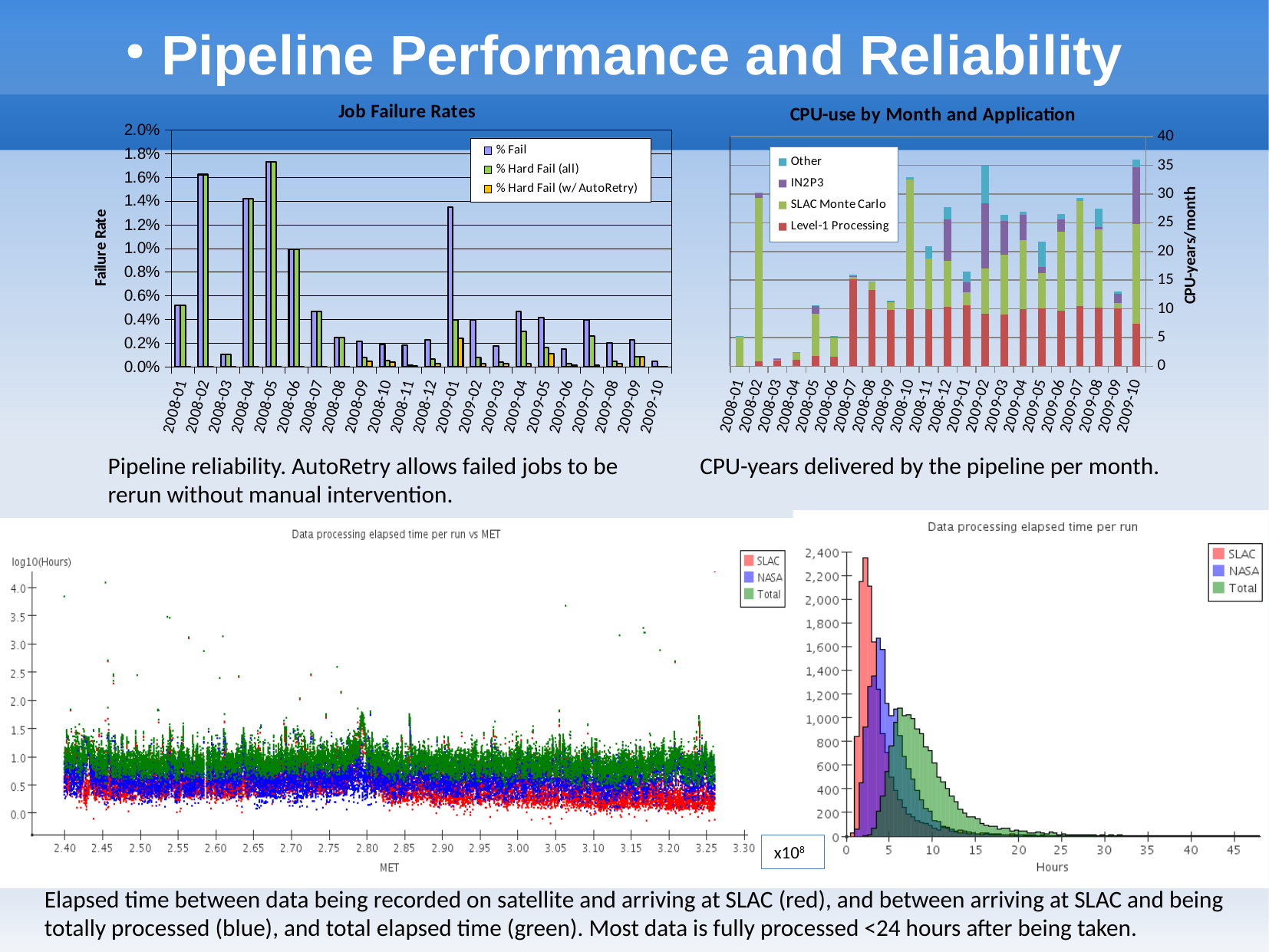
In the Data processing elapsed time per run chart at the bottom right, is the peak of the SLAC histogram greater or less than 2,200? greater In the CPU-use by Month and Application chart, what is the label of the y axis? CPU-years/month In the Job Failure Rates chart, is the % Fail value for 2008-05 greater or less than 1.6%? greater In the Job Failure Rates chart, is the % Fail value for 2008-03 greater or less than 0.2%? less In the Job Failure Rates chart, how many series does the legend list? 3 In the Job Failure Rates chart, how many months are shown on the x axis? 22 In the Job Failure Rates chart, which is larger, the % Fail value for 2008-02 or for 2008-06? 2008-02 What kind of chart is the CPU-use by Month and Application chart? stacked bar chart In the CPU-use by Month and Application chart, how many series does the legend list? 4